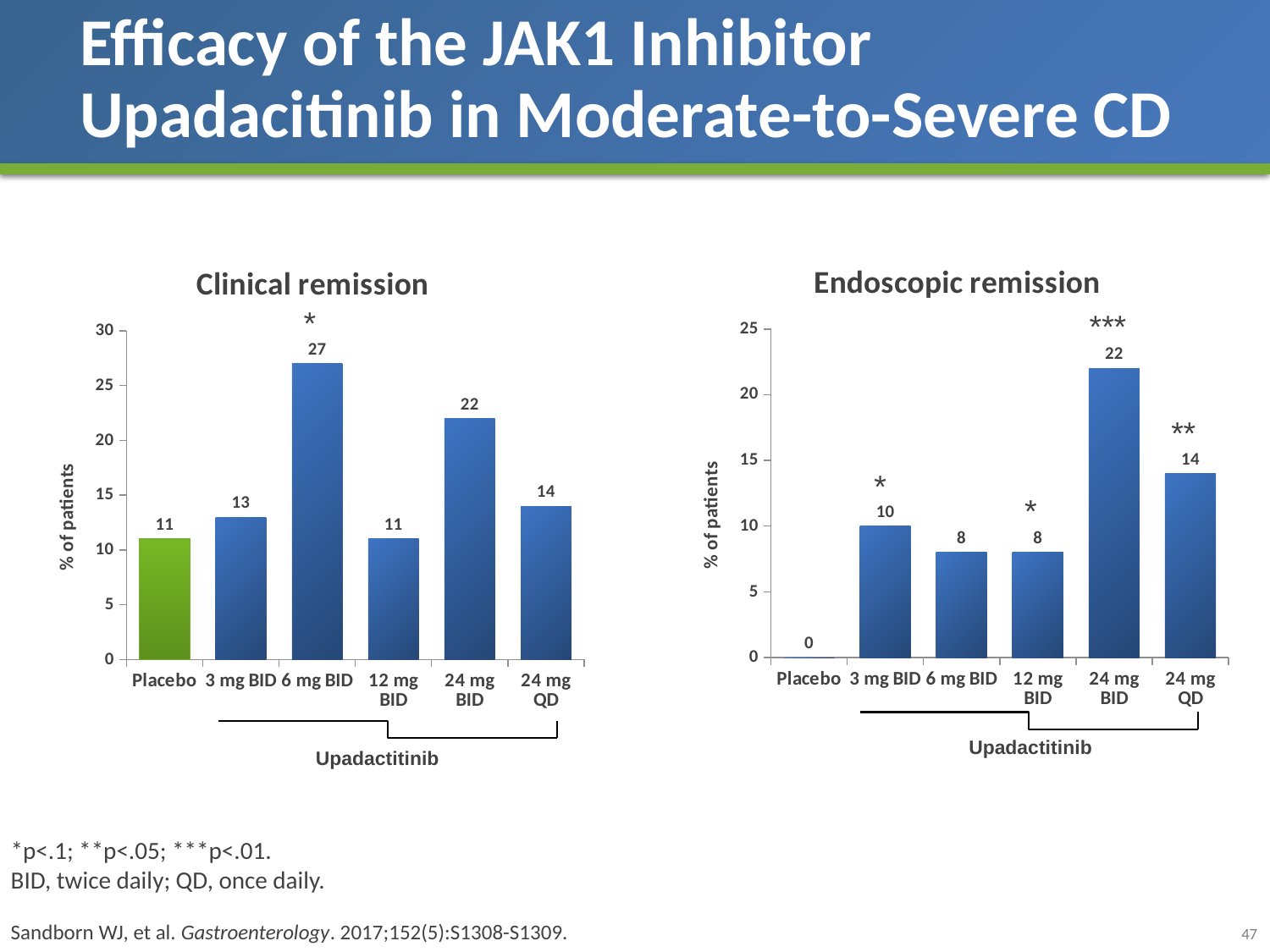
In the Endoscopic remission chart, what is the value for 24 mg BID? 22 In the Clinical remission chart, what is the difference between the values for 6 mg BID and Placebo? 16 In the Endoscopic remission chart, which category has the lowest value? Placebo In the Clinical remission chart, which is larger, the value for 24 mg BID or the value for 24 mg QD? 24 mg BID What is the y-axis label of the Endoscopic remission chart? % of patients In the Endoscopic remission chart, what is the difference between the values for 24 mg BID and 24 mg QD? 8 In the Clinical remission chart, which category has the highest value? 6 mg BID What kind of chart is the Clinical remission chart? Bar chart In the Endoscopic remission chart, what is the value for Placebo? 0 In the Clinical remission chart, what is the value for 6 mg BID? 27 In the Clinical remission chart, what is the value for Placebo? 11 How many categories are shown in the Endoscopic remission chart? 6